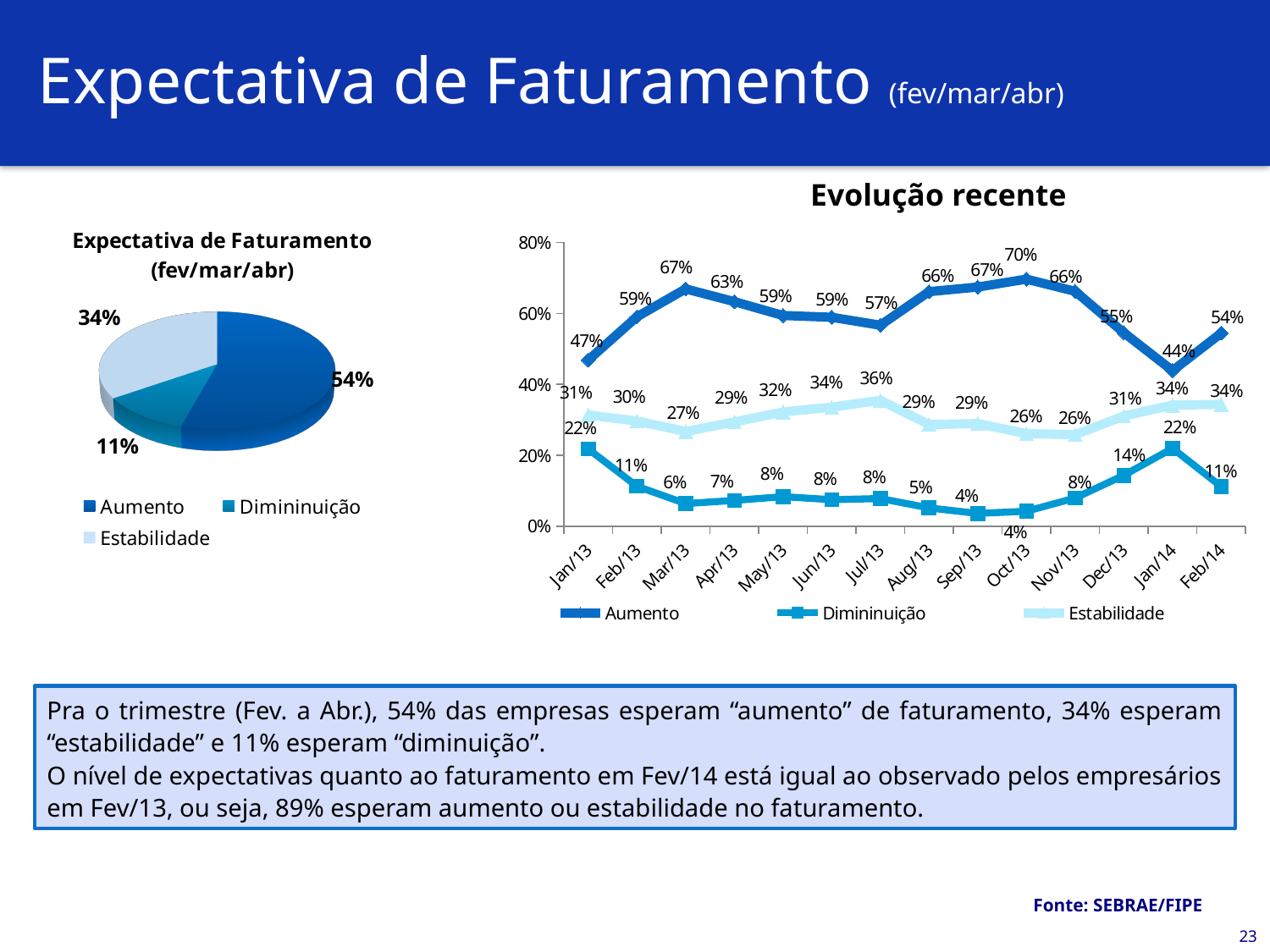
In the 'Evolução recente' chart, what is the value for Diminuição in Jan/14? 22% In the pie chart 'Expectativa de Faturamento (fev/mar/abr)', how many slices are there? 3 What type of chart is 'Evolução recente'? Line chart In the 'Evolução recente' chart, what is the value for Estabilidade in Jul/13? 36% In the 'Evolução recente' chart, which is larger: Estabilidade in Jul/13 or Estabilidade in Oct/13? Jul/13 In the 'Evolução recente' chart, how many series does the legend list? 3 In the 'Evolução recente' chart, what is the value for Aumento in Oct/13? 70% In the pie chart 'Expectativa de Faturamento (fev/mar/abr)', which category has the smallest slice? Dimininuição In the 'Evolução recente' chart, in which month does Aumento reach its highest value? Oct/13 In the 'Evolução recente' chart, how many months are plotted on the x axis? 14 In the pie chart 'Expectativa de Faturamento (fev/mar/abr)', what share is shown for Aumento? 54% In the 'Evolução recente' chart, what is the difference between the Aumento values in Oct/13 and Jan/14? 26%